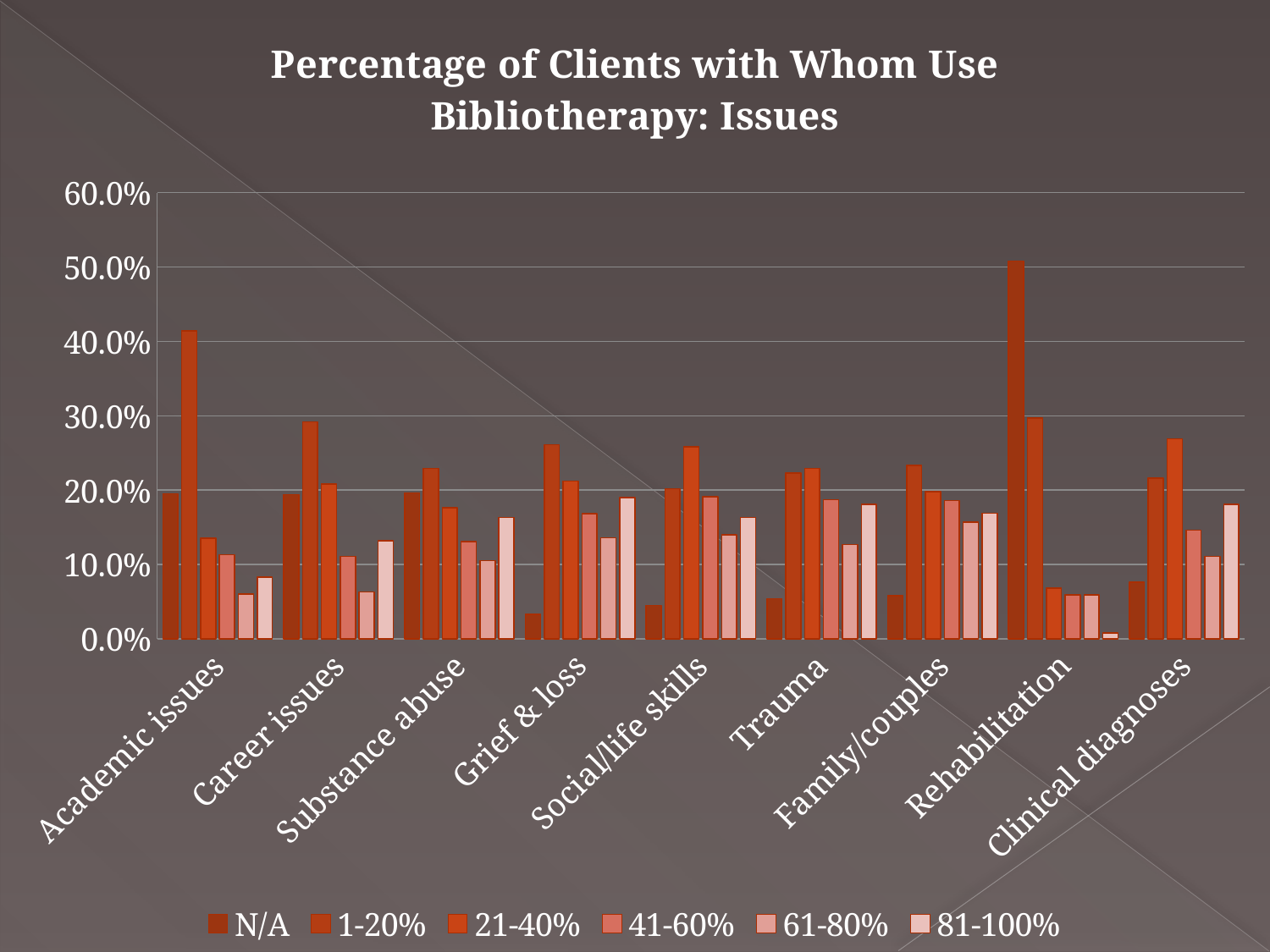
Is the 1-20% value for Academic issues greater or less than 30.0%? greater Is the N/A value for Rehabilitation greater or less than 40.0%? greater How many issue categories are shown along the x axis? 9 How many series does the legend list? 6 Which category and series has the tallest bar in the chart? Rehabilitation, N/A Which is larger: the 1-20% value for Academic issues or the 1-20% value for Career issues? Academic issues What is the title of the chart? Percentage of Clients with Whom Use Bibliotherapy: Issues Within the Rehabilitation category, which series has the lowest bar? 81-100% What type of chart is shown on the slide? bar chart Is the N/A value for Grief & loss greater or less than 10.0%? less Within the Academic issues category, which series has the highest bar? 1-20%